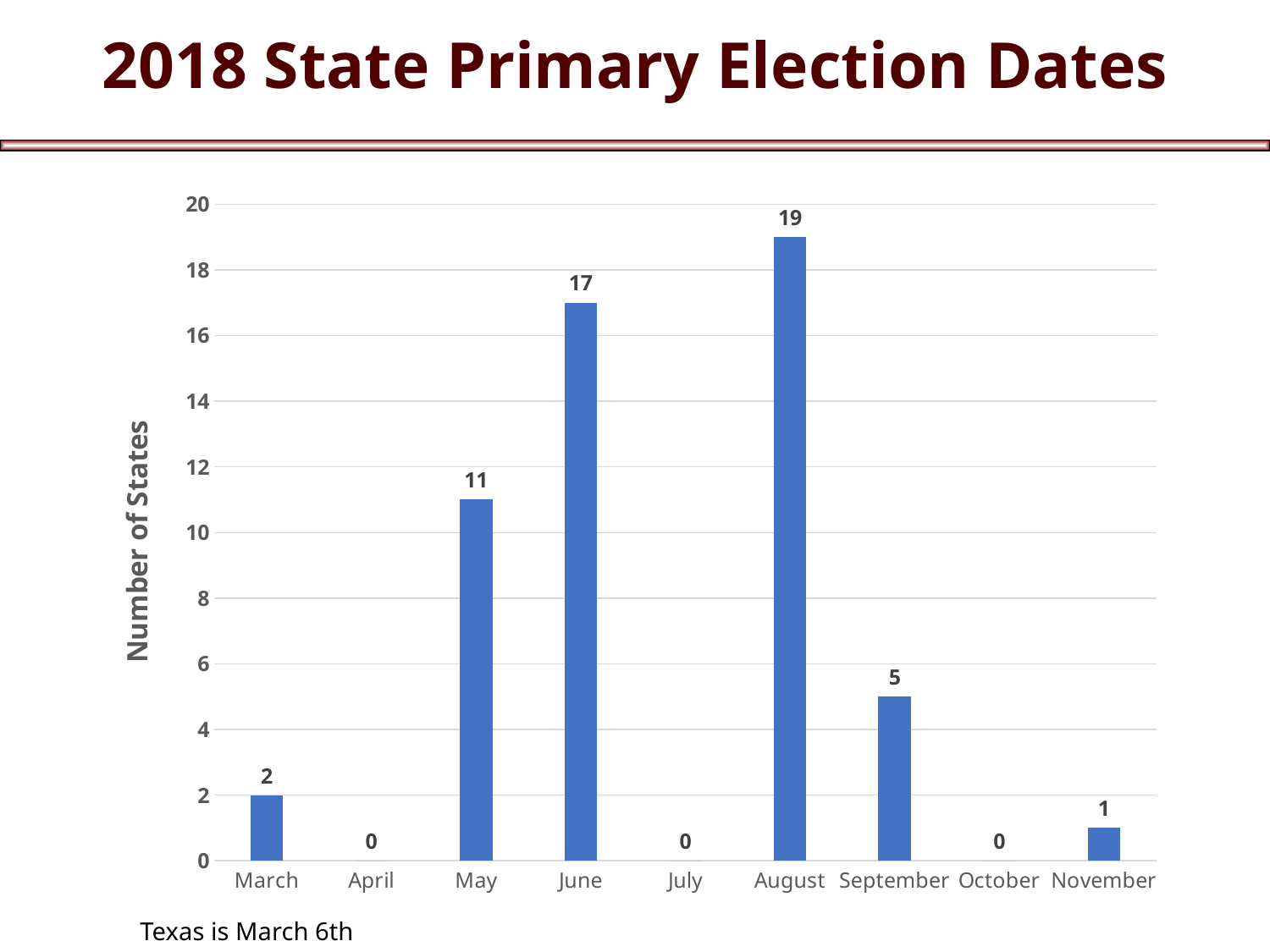
Which months have a value of 0? April, July, October What is the value shown for November? 1 How many states have their primary in May? 11 Which month has the highest number of states? August How many states hold their primary election in August? 19 What kind of chart is shown on the slide? Bar chart What is the difference between the values for May and September? 6 What is the label of the vertical axis? Number of States What is the number of states for June? 17 Which has more states, March or September? September How many months are shown on the x axis? 9 What is the difference between the number of states in August and in June? 2